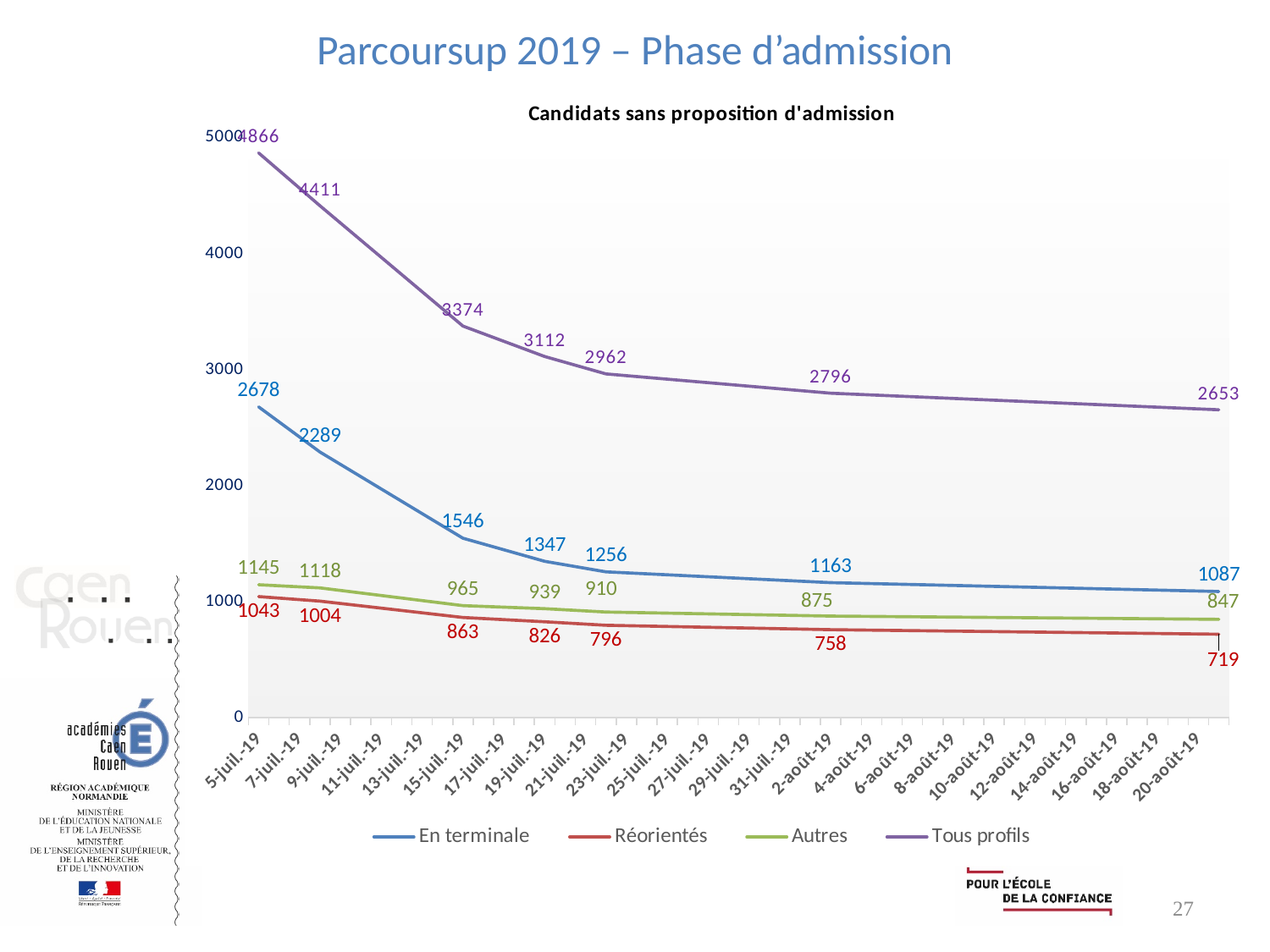
What is the title of the chart? Candidats sans proposition d'admission How many series does the legend list? 4 Do the values of the En terminale series rise or fall over time along the x axis? fall What is the value for Tous profils on 5-juil-19? 4866 What is the highest value plotted for the Tous profils series? 4866 By how much does the Tous profils value fall between 5-juil-19 and 20-août-19? 2213 What is the value for Réorientés on 5-juil-19? 1043 Which series has the larger value on 20-août-19, Autres or Réorientés? Autres What is the value for En terminale on 20-août-19? 1087 What is the lowest value plotted for the Réorientés series? 719 What is the value for Autres on 20-août-19? 847 What kind of chart is shown on the slide? line chart